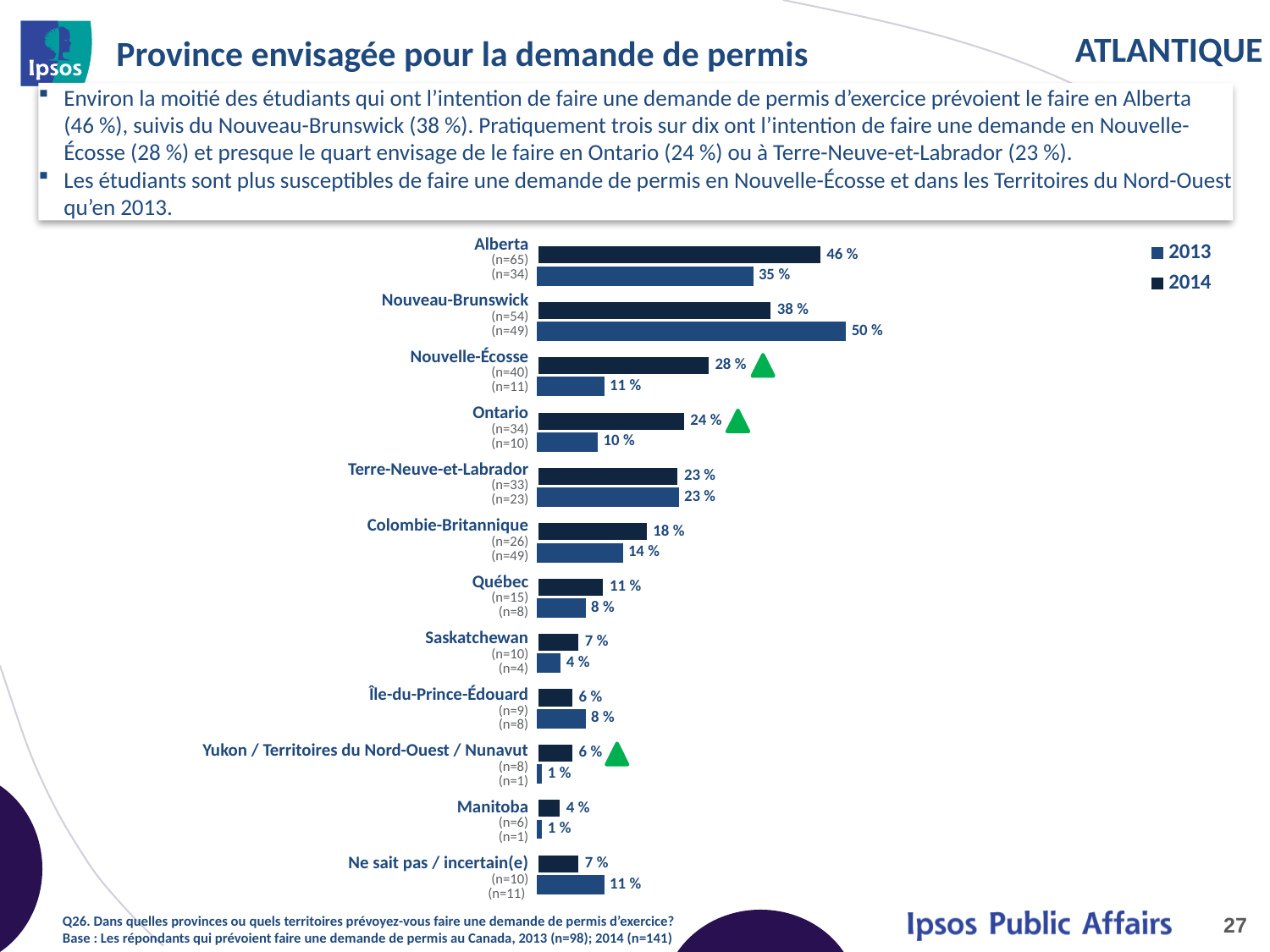
How many series does the legend list? 2 What is the value of the upper bar for Alberta (n=65)? 46 % What is the value of the upper bar for Ontario (n=34)? 24 % What is the value of the lower bar for Nouveau-Brunswick (n=49)? 50 % For Île-du-Prince-Édouard, which bar is larger, the upper bar (n=9) or the lower bar (n=8)? the lower bar (8 %) How many provinces/territories or response categories are plotted on the chart? 12 What kind of chart is shown on the slide? bar chart What is the difference between the upper bar (28 %) and the lower bar (11 %) for Nouvelle-Écosse? 17 percentage points What is the value of the lower bar for Nouvelle-Écosse (n=11)? 11 % Which two entries appear in the chart legend? 2013 and 2014 Which category has the highest value among the upper bars? Alberta What are the two values shown for Terre-Neuve-et-Labrador? 23 % and 23 %